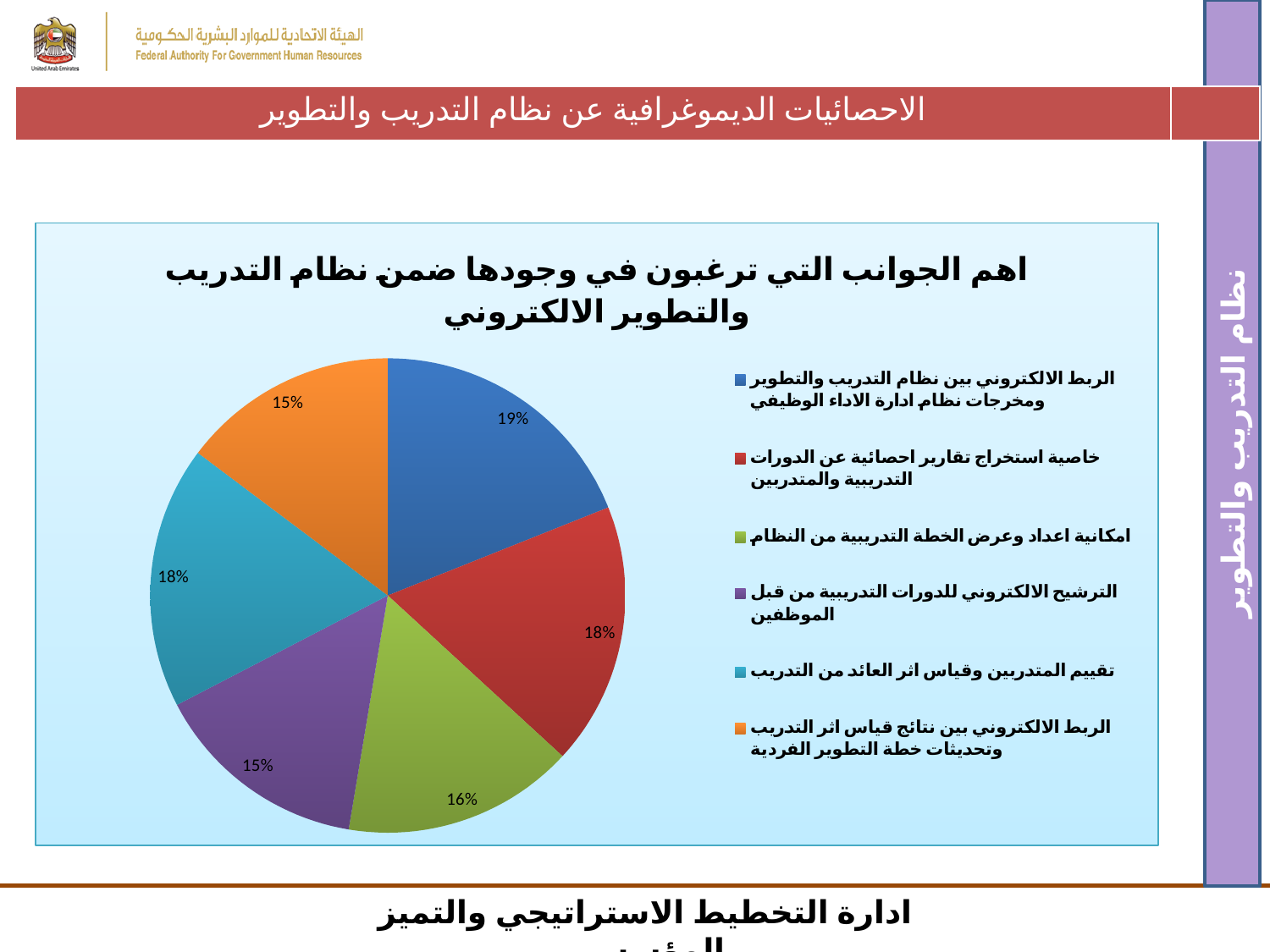
Which is larger: the share for 'الربط الالكتروني بين نظام التدريب والتطوير ومخرجات نظام ادارة الاداء الوظيفي' or the share for 'امكانية اعداد وعرض الخطة التدريبية من النظام'? الربط الالكتروني بين نظام التدريب والتطوير ومخرجات نظام ادارة الاداء الوظيفي What percentage is shown for 'تقييم المتدربين وقياس اثر العائد من التدريب'? 18% What is the difference in percentage points between the largest slice (19%) and the slice for 'الربط الالكتروني بين نتائج قياس اثر التدريب وتحديثات خطة التطوير الفردية'? 4 What percentage is shown for 'الترشيح الالكتروني للدورات التدريبية من قبل الموظفين'? 15% What percentage is shown for 'خاصية استخراج تقارير احصائية عن الدورات التدريبية والمتدربين'? 18% What colour is the slice for 'الربط الالكتروني بين نتائج قياس اثر التدريب وتحديثات خطة التطوير الفردية'? orange What is the title of the pie chart? اهم الجوانب التي ترغبون في وجودها ضمن نظام التدريب والتطوير الالكتروني How many slices does the pie chart have? 6 Which category has the largest share of the pie? الربط الالكتروني بين نظام التدريب والتطوير ومخرجات نظام ادارة الاداء الوظيفي What share of the pie is labelled for 'الربط الالكتروني بين نظام التدريب والتطوير ومخرجات نظام ادارة الاداء الوظيفي'? 19% What percentage is shown for 'امكانية اعداد وعرض الخطة التدريبية من النظام'? 16% What type of chart is shown on the slide? pie chart